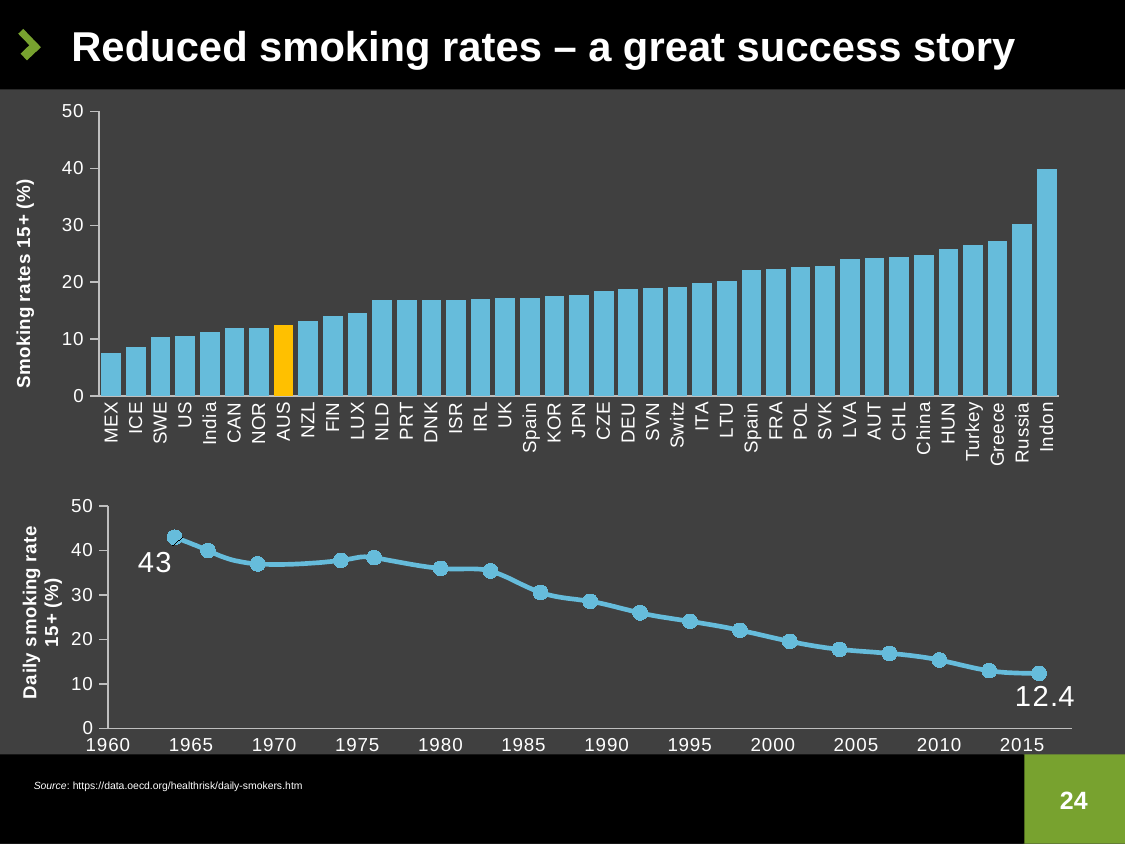
What type of chart is the top chart on the slide? bar chart In the top bar chart, which country has the lowest smoking rate? MEX In the top bar chart, which has the larger smoking rate, AUS or Greece? Greece In the top bar chart, is the value for Indon greater or less than 30? greater What type of chart is the bottom chart on the slide? line chart In the top bar chart, which country has the highest smoking rate? Indon In the bottom line chart, what is the value labelled at the first data point? 43 In the top bar chart, is the value for AUS greater or less than 20? less In the top bar chart, is the value for Russia greater or less than 20? greater In the top bar chart, which bar is highlighted in a different colour (orange) from the rest? AUS In the bottom line chart, does the daily smoking rate rise or fall over time? fall In the bottom line chart, what is the value labelled at the last data point? 12.4